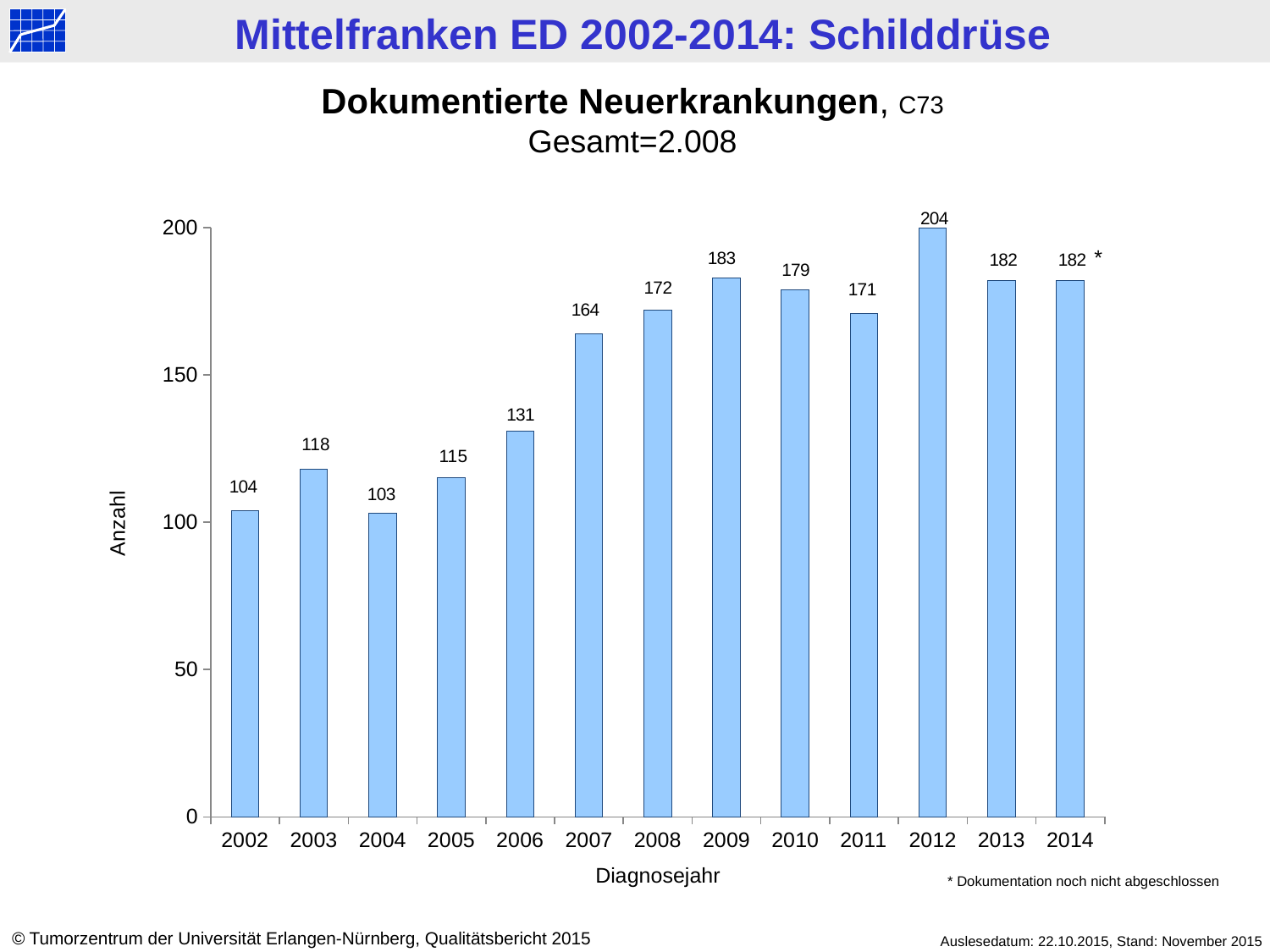
What is the difference between the values for 2012 and 2002? 100 Which year has a larger value, 2010 or 2011? 2010 What total (Gesamt) is stated in the chart subtitle? 2.008 Which diagnosis year has the highest number of new cases? 2012 What kind of chart is shown on the slide? bar chart What is the value shown for the year 2004? 103 How many diagnosis years are shown on the x axis? 13 Which diagnosis year has the lowest number of new cases? 2004 What is the label of the y axis? Anzahl What is the number of documented new cases (Anzahl) for 2009? 183 Is the value for 2007 greater or less than 150? greater Do the values generally rise or fall from 2002 to 2012? rise